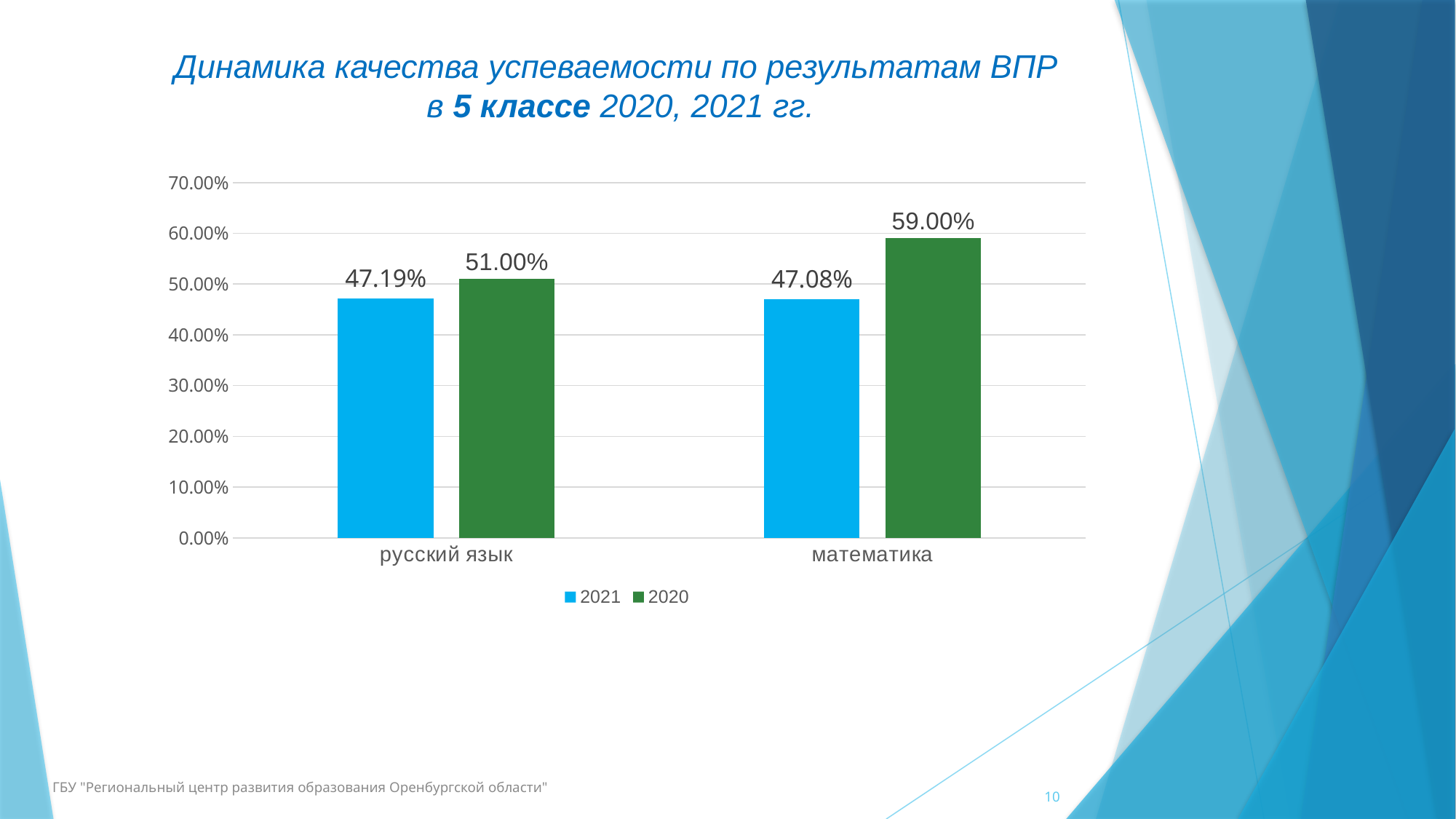
Is the value for математика in 2020 greater or less than 50.00%? greater What is the value for русский язык in 2020? 51.00% What is the difference between the 2020 and 2021 values for математика? 11.92% What is the value for математика in 2020? 59.00% How many subject categories are shown on the x axis? 2 Which is larger for русский язык: the 2020 value or the 2021 value? 2020 What is the difference between the 2020 and 2021 values for русский язык? 3.81% What is the value for русский язык in 2021? 47.19% What is the value for математика in 2021? 47.08% How many series does the legend list? 2 What type of chart is shown on the slide? bar chart Which subject has the highest value in the 2020 series? математика